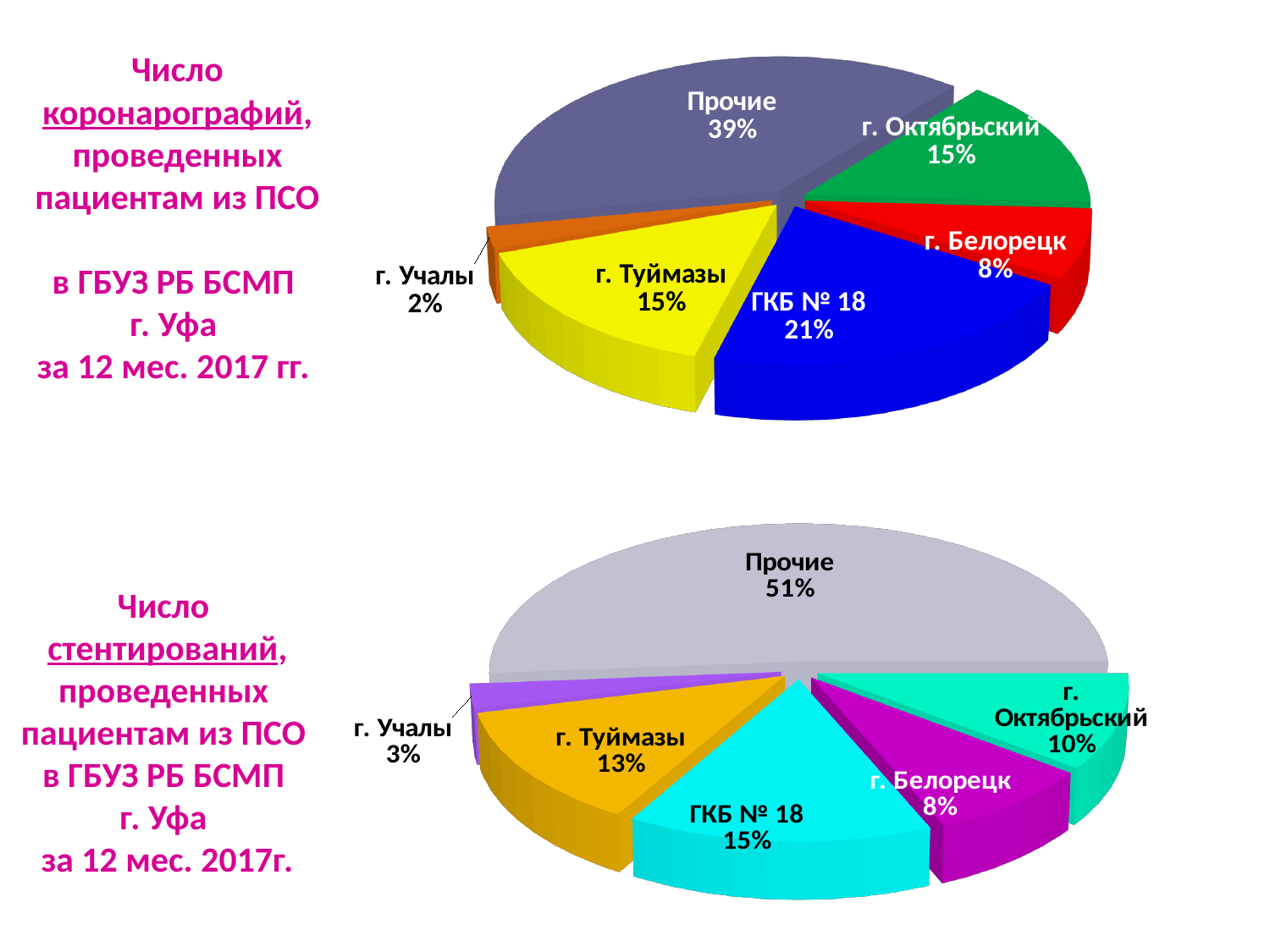
In the bottom pie chart (стентирования), what is the difference between the shares of ГКБ № 18 and г. Белорецк? 7% In the top pie chart (коронарографии), what share does ГКБ № 18 have? 21% In the bottom pie chart (стентирования), which is larger: the share of ГКБ № 18 or the share of г. Октябрьский? ГКБ № 18 In the top pie chart (коронарографии), what share does г. Учалы have? 2% In the top pie chart (коронарографии), which category has the largest share? Прочие In the top pie chart (коронарографии), which category has the smallest share? г. Учалы In the top pie chart (коронарографии), what is the difference between the shares of Прочие and ГКБ № 18? 18% In the bottom pie chart (стентирования), what share does Прочие have? 51% In the bottom pie chart (стентирования), which category has the smallest share? г. Учалы In the top pie chart (коронарографии), how many slices are there? 6 In the bottom pie chart (стентирования), what share does г. Туймазы have? 13% What type of chart is shown at the bottom of the slide? Pie chart